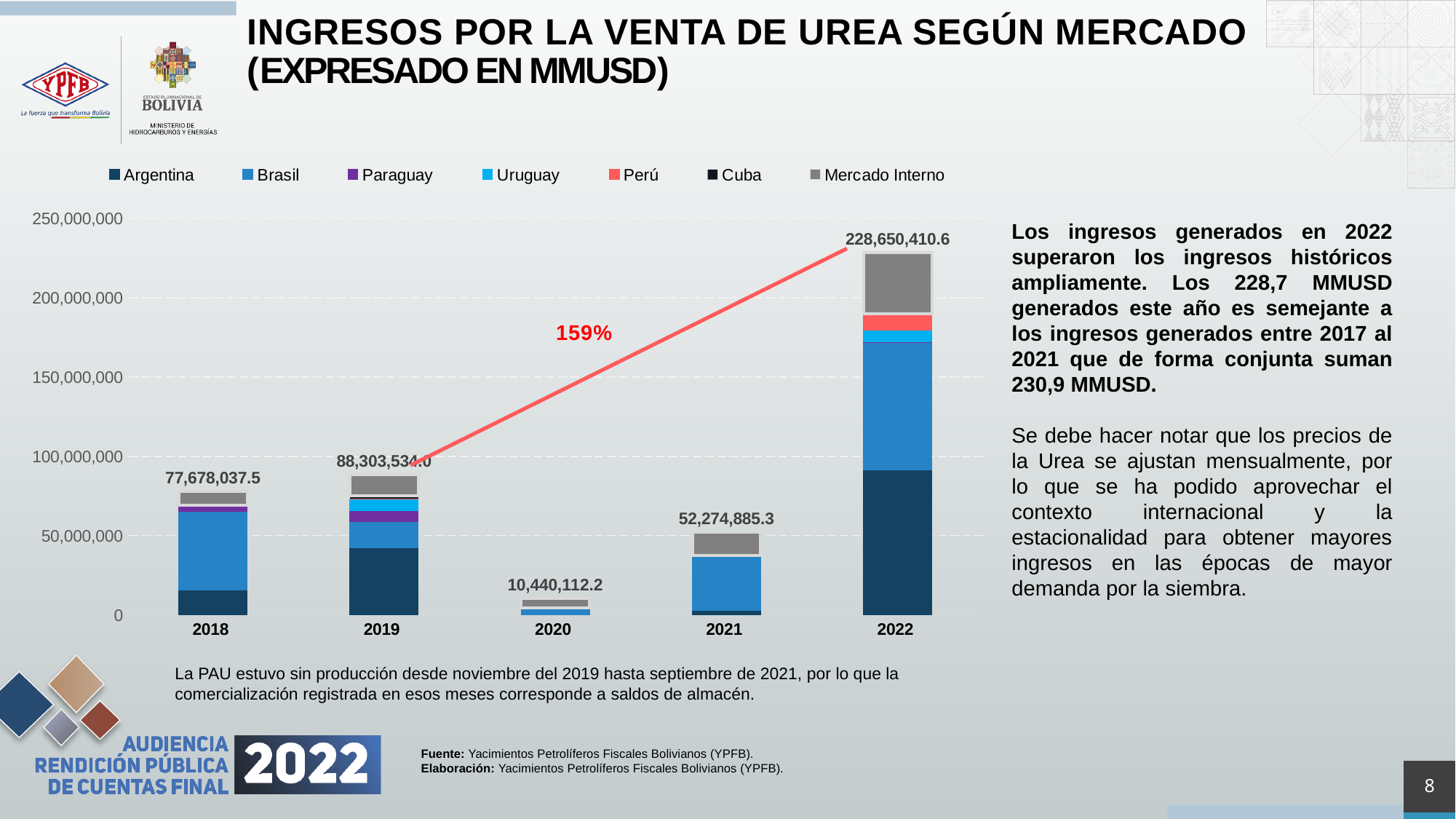
Which year has the highest total income from urea sales? 2022 What type of chart is shown on the slide? Stacked bar chart What is the total income from urea sales in 2022? 228,650,410.6 How many series does the legend list? 7 Which year has the lowest total income from urea sales? 2020 What percentage growth is annotated on the arrow between 2019 and 2022? 159% What is the total income from urea sales in 2020? 10,440,112.2 What is the difference between the total income in 2022 and in 2021? 176,375,525.3 Is the Argentina segment of the 2018 bar greater or less than 50,000,000? less What is the total income from urea sales in 2021? 52,274,885.3 What is the total income from urea sales in 2018? 77,678,037.5 Which year had a larger total income, 2018 or 2021? 2018